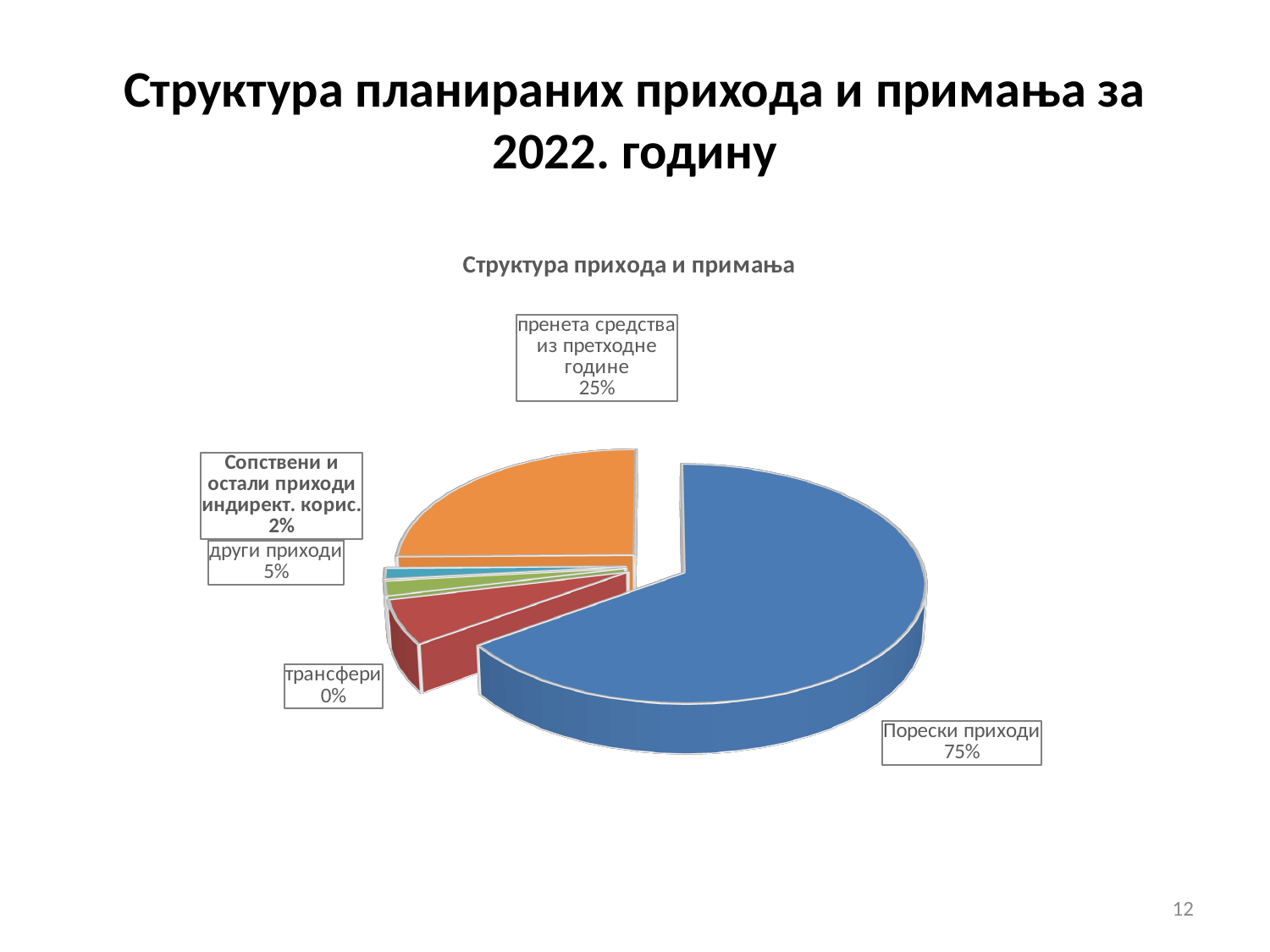
What is the title of the chart? Структура прихода и примања Which category has the largest slice of the pie? Порески приходи What kind of chart is shown on the slide? pie chart Which is larger, the share for други приходи or the share for Сопствени и остали приходи индирект. корис.? други приходи What percentage is shown for Сопствени и остали приходи индирект. корис.? 2% What percentage is shown for пренета средства из претходне године? 25% How many categories are labelled on the pie chart? 5 What percentage is shown for трансфери? 0% Which category has the smallest labelled share? трансфери What share of the pie is labelled for Порески приходи? 75% What percentage is shown for други приходи? 5% By how many percentage points does Порески приходи exceed пренета средства из претходне године? 50 percentage points